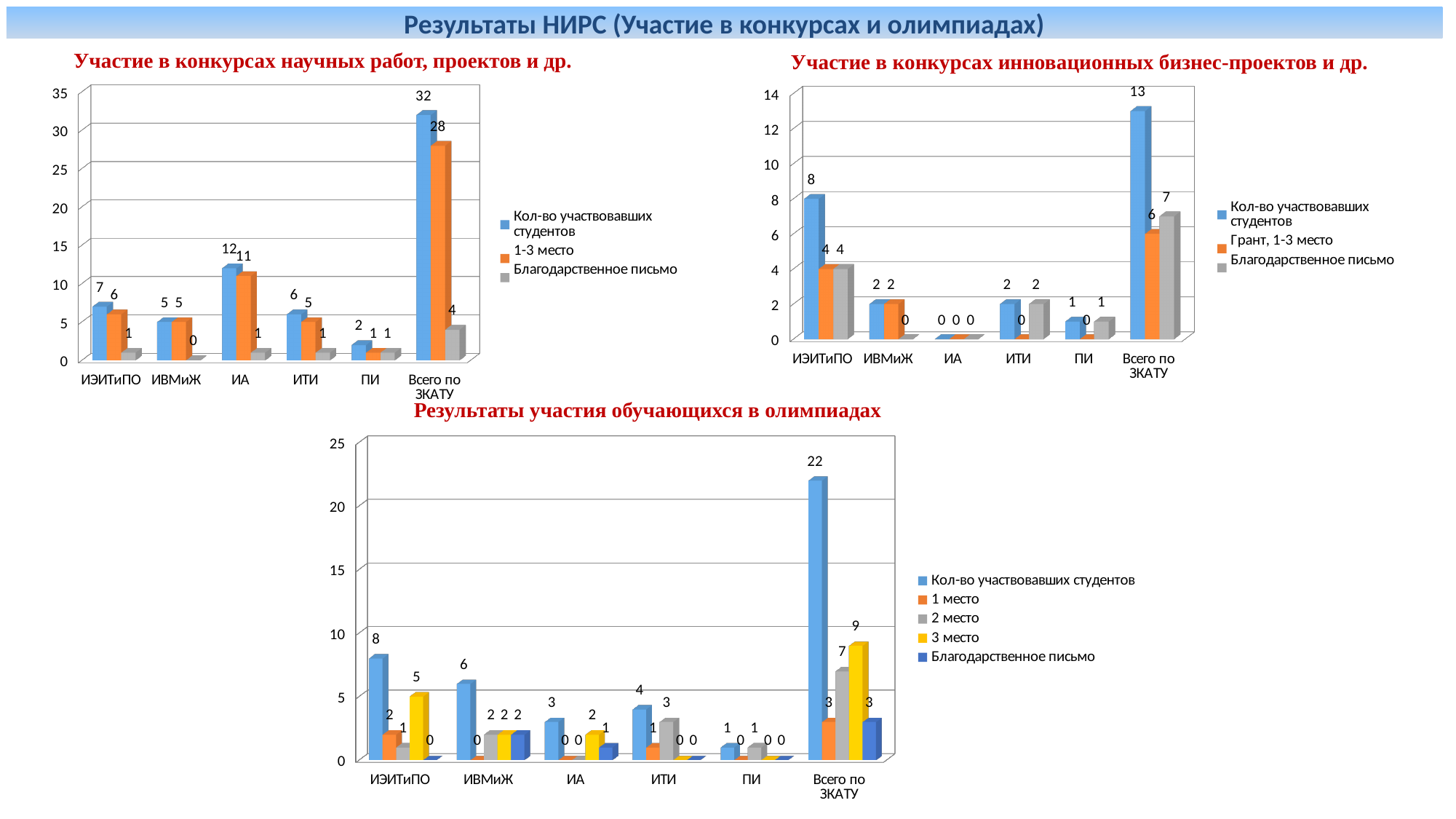
In the chart 'Участие в конкурсах инновационных бизнес-проектов и др.', how many categories are shown on the x axis? 6 In the chart 'Результаты участия обучающихся в олимпиадах', which is larger: 'Кол-во участвовавших студентов' for ИЭИТиПО or for ИВМиЖ? ИЭИТиПО In the chart 'Результаты участия обучающихся в олимпиадах', what is the value of '3 место' for Всего по ЗКАТУ? 9 In the chart 'Участие в конкурсах инновационных бизнес-проектов и др.', what is the value of 'Благодарственное письмо' for Всего по ЗКАТУ? 7 What type of chart is 'Результаты участия обучающихся в олимпиадах'? Bar chart In the chart 'Участие в конкурсах научных работ, проектов и др.', what is the difference between 'Кол-во участвовавших студентов' and '1-3 место' for Всего по ЗКАТУ? 4 In the chart 'Участие в конкурсах научных работ, проектов и др.', what is the value of '1-3 место' for Всего по ЗКАТУ? 28 In the chart 'Участие в конкурсах инновационных бизнес-проектов и др.', what is the value of 'Грант, 1-3 место' for ИЭИТиПО? 4 In the chart 'Результаты участия обучающихся в олимпиадах', how many series does the legend list? 5 In the chart 'Участие в конкурсах научных работ, проектов и др.', what is the value of 'Кол-во участвовавших студентов' for ИА? 12 In the chart 'Участие в конкурсах инновационных бизнес-проектов и др.', which category has the highest value of 'Кол-во участвовавших студентов'? Всего по ЗКАТУ In the chart 'Участие в конкурсах научных работ, проектов и др.', how many series does the legend list? 3